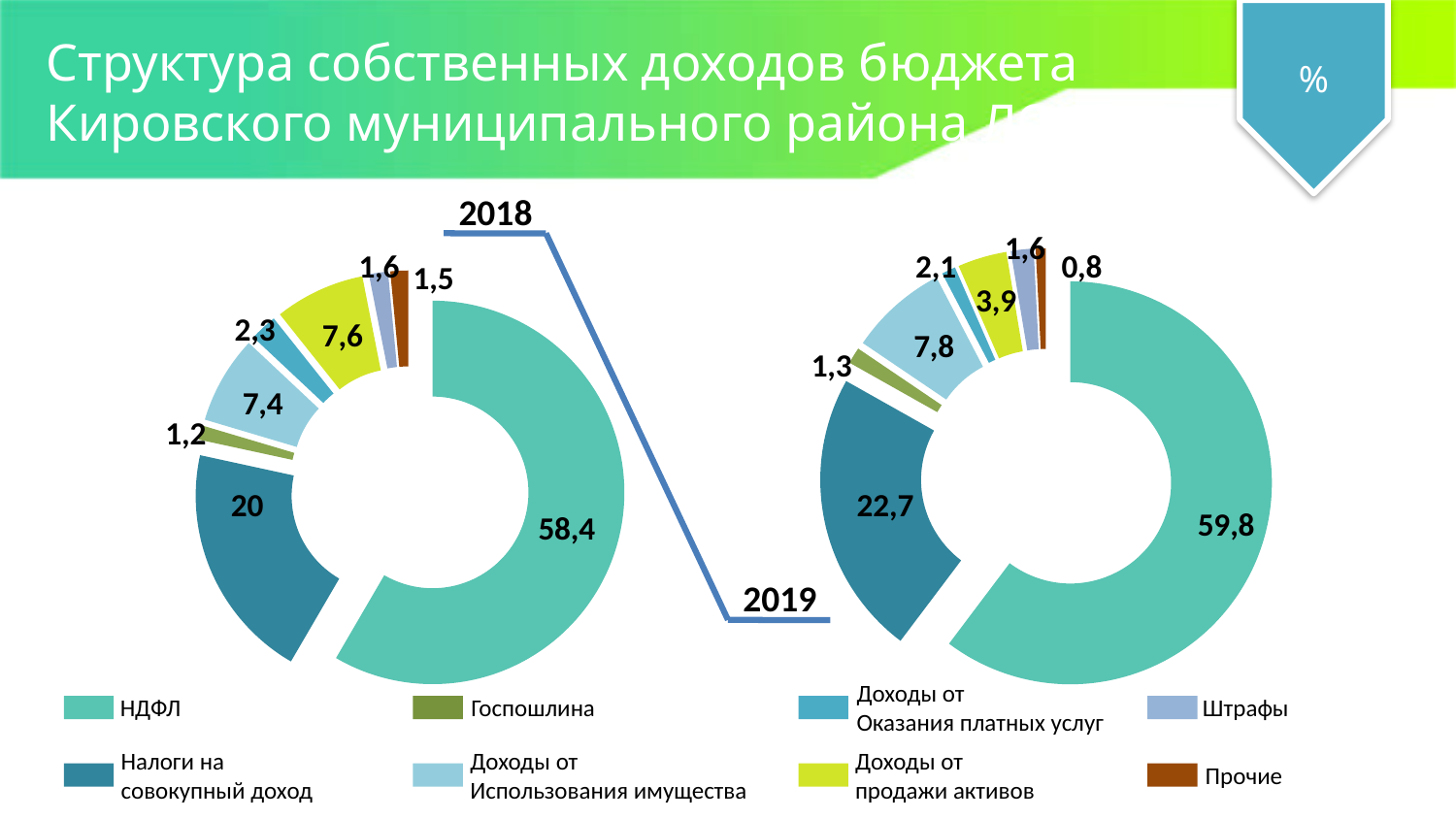
In the 2019 chart, what is the share for Налоги на совокупный доход? 22,7 In the 2018 chart, what is the share for НДФЛ? 58,4 In the 2018 chart, which category has the smallest share? Госпошлина In the 2019 chart, what is the value for Прочие? 0,8 In the 2019 chart, which category has the largest share? НДФЛ How many categories does the legend list? 8 By how much did the share of НДФЛ change from the 2018 chart to the 2019 chart? 1,4 What is the difference between Доходы от продажи активов in the 2018 chart and in the 2019 chart? 3,7 What kind of chart is used to show the 2018 budget income structure? Pie (donut) chart Which is larger: Доходы от использования имущества in 2018 or in 2019? 2019 In the 2019 chart, which category has the smallest share? Прочие In the 2018 chart, what is the value for Доходы от продажи активов? 7,6